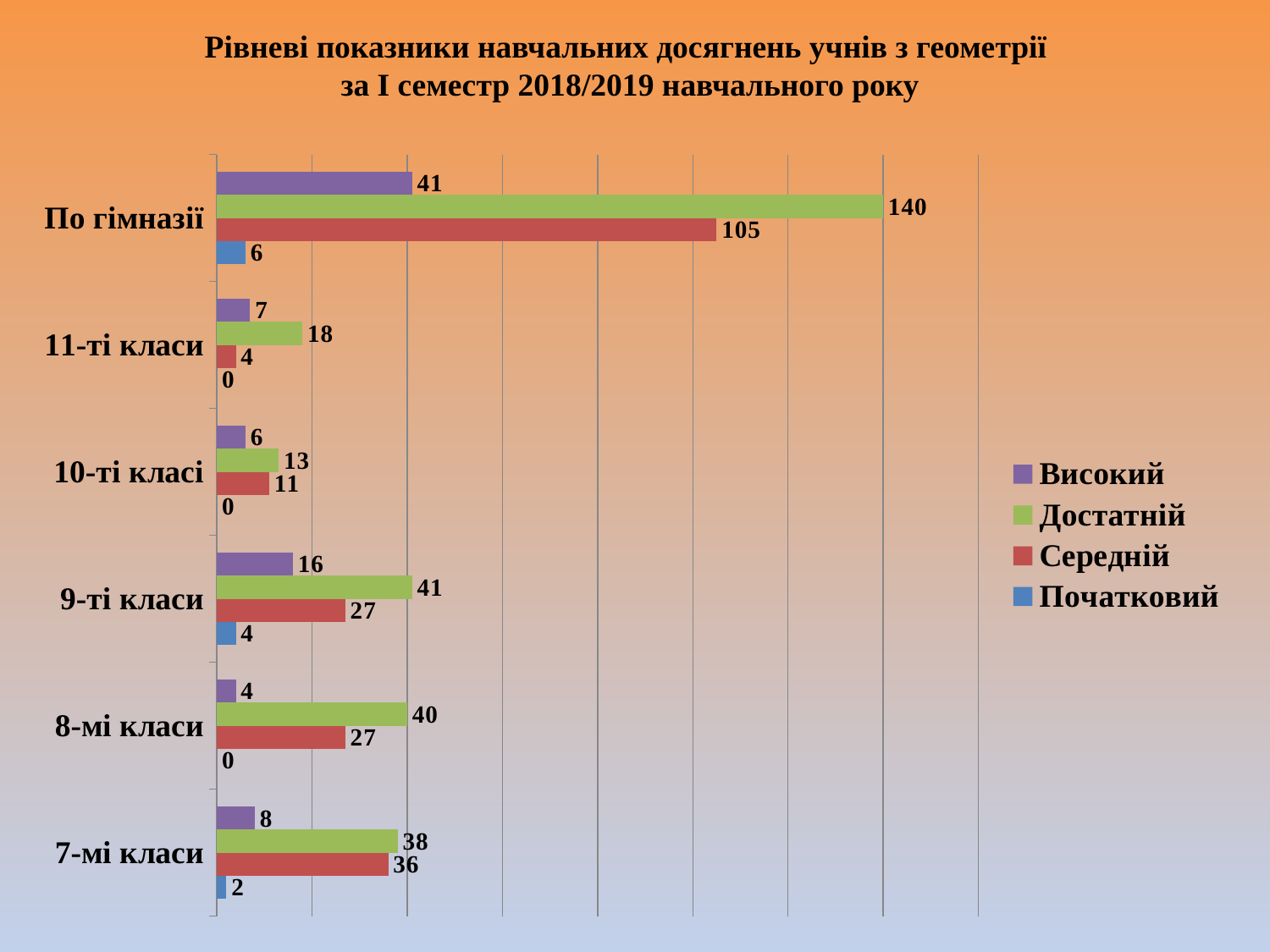
How many categories are shown on the chart? 6 What is the value of Середній for 7-мі класи? 36 Which is larger for 10-ті класі: the Достатній value or the Середній value? Достатній How many series does the legend list? 4 What is the value of Початковий for 11-ті класи? 0 What is the difference between the Достатній and Середній values for По гімназії? 35 What is the value of Високий for 9-ті класи? 16 What is the value of Достатній for По гімназії? 140 Which series is shown in green in the legend? Достатній What kind of chart is shown on the slide? bar chart Which category has the highest value for Достатній? По гімназії Among the class categories (excluding По гімназії), which has the lowest value for Високий? 8-мі класи